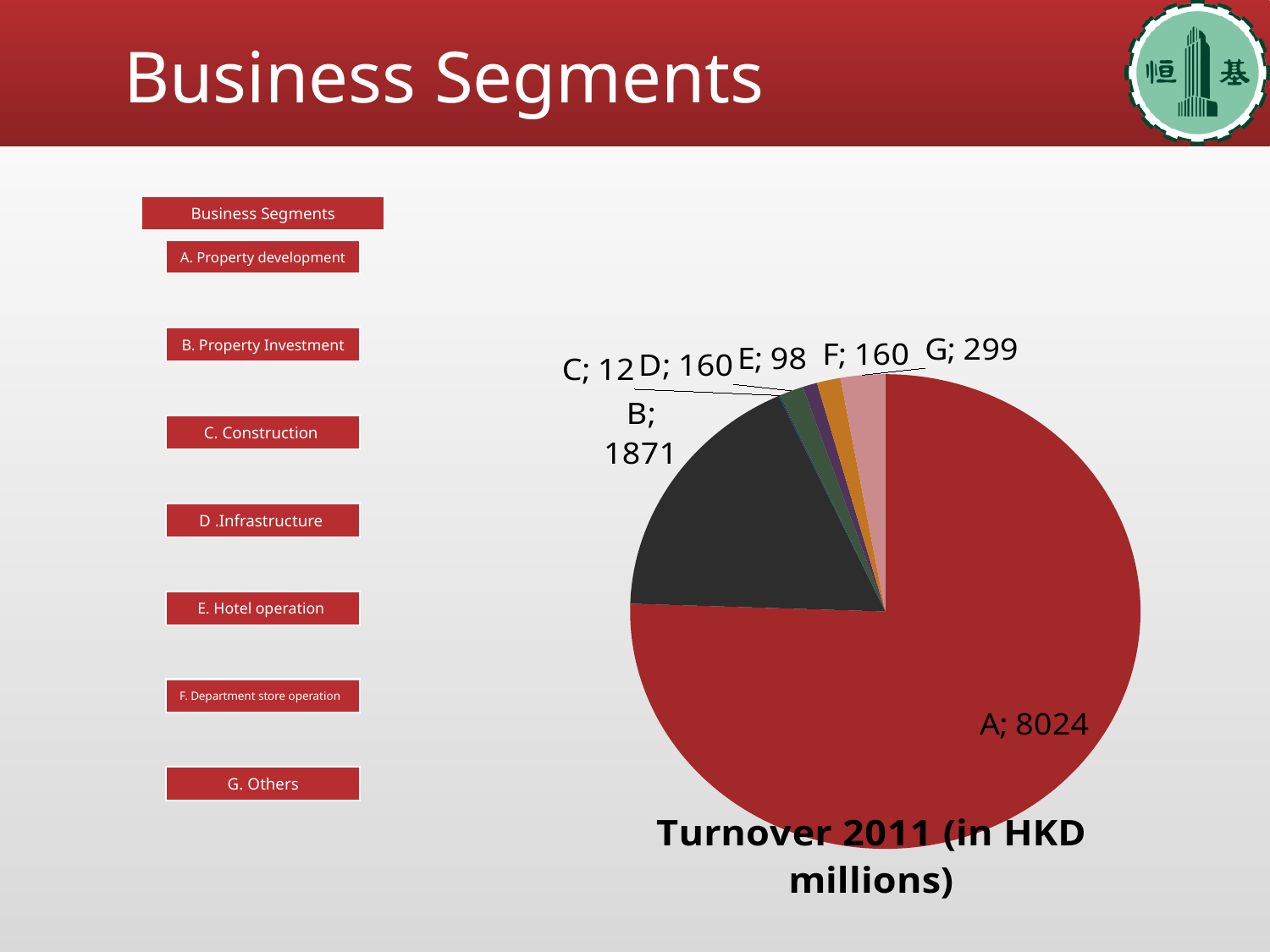
What is the total turnover across all segments in the pie chart? 10624 What is the title of the pie chart? Turnover 2011 (in HKD millions) What is the turnover value for segment G in the pie chart? 299 What type of chart is shown on the slide? Pie chart What is the turnover value for segment B in the pie chart? 1871 Which segment has the smallest slice in the pie chart? C Which is larger, the turnover for segment G or segment D? G What is the turnover value for segment A in the pie chart? 8024 What is the difference between the turnover values of segment A and segment B? 6153 What is the turnover value for segment E in the pie chart? 98 Which segment has the largest slice in the pie chart? A How many slices does the pie chart have? 7